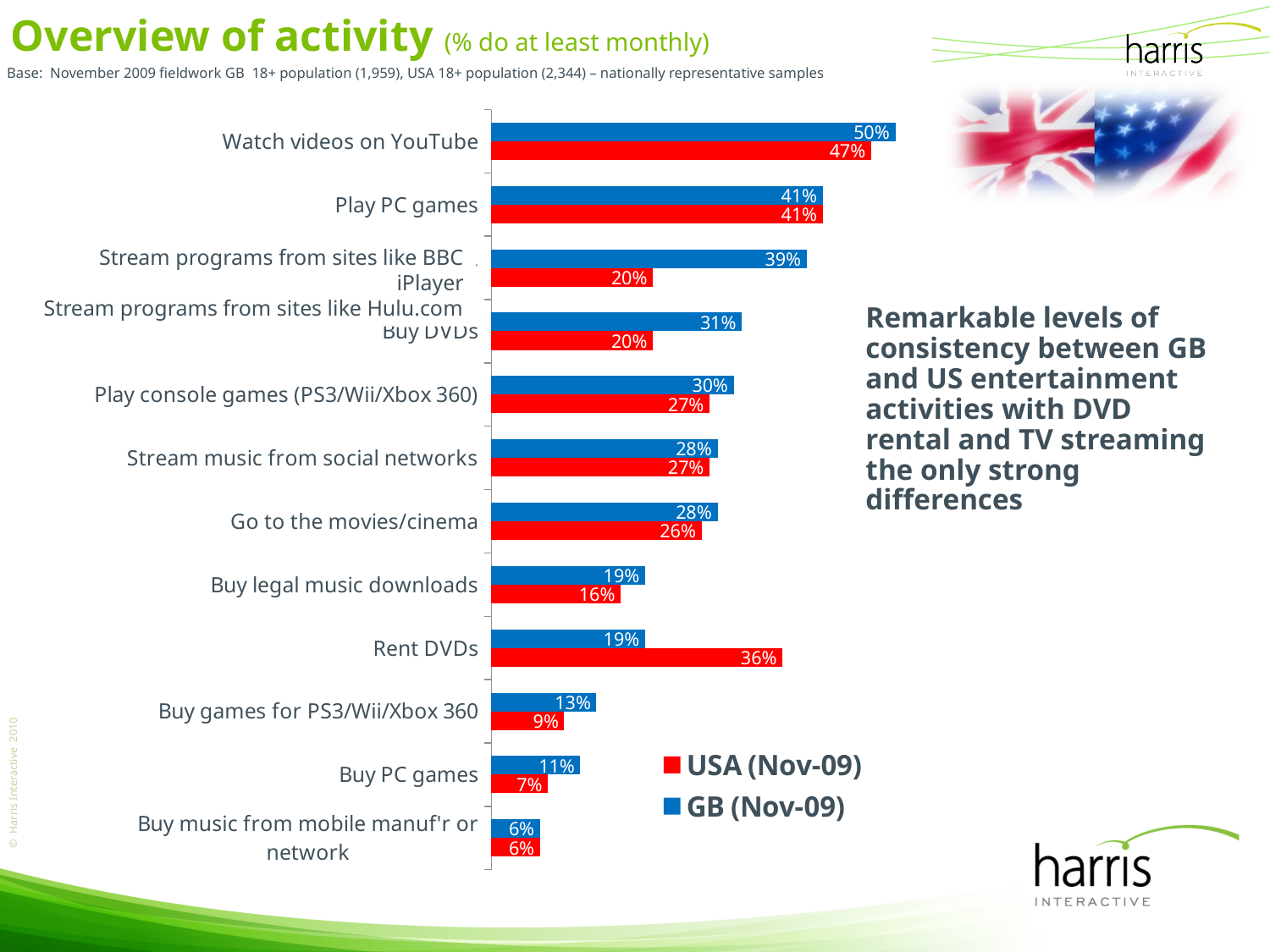
Which colour represents the USA (Nov-09) series? Red What kind of chart is shown on the slide? Bar chart Which activity has the highest GB (Nov-09) value? Watch videos on YouTube What is the GB (Nov-09) value for Watch videos on YouTube? 50% What is the USA (Nov-09) value for Go to the movies/cinema? 26% What is the GB (Nov-09) value for Buy games for PS3/Wii/Xbox 360? 13% How many activities are shown in the chart? 12 Which activity has the lowest USA (Nov-09) value? Buy music from mobile manuf'r or network What is the difference between the GB (Nov-09) and USA (Nov-09) values for Rent DVDs? 17% How many series does the legend list? 2 For Buy PC games, which is larger: the USA (Nov-09) value or the GB (Nov-09) value? GB (Nov-09) What is the USA (Nov-09) value for Rent DVDs? 36%